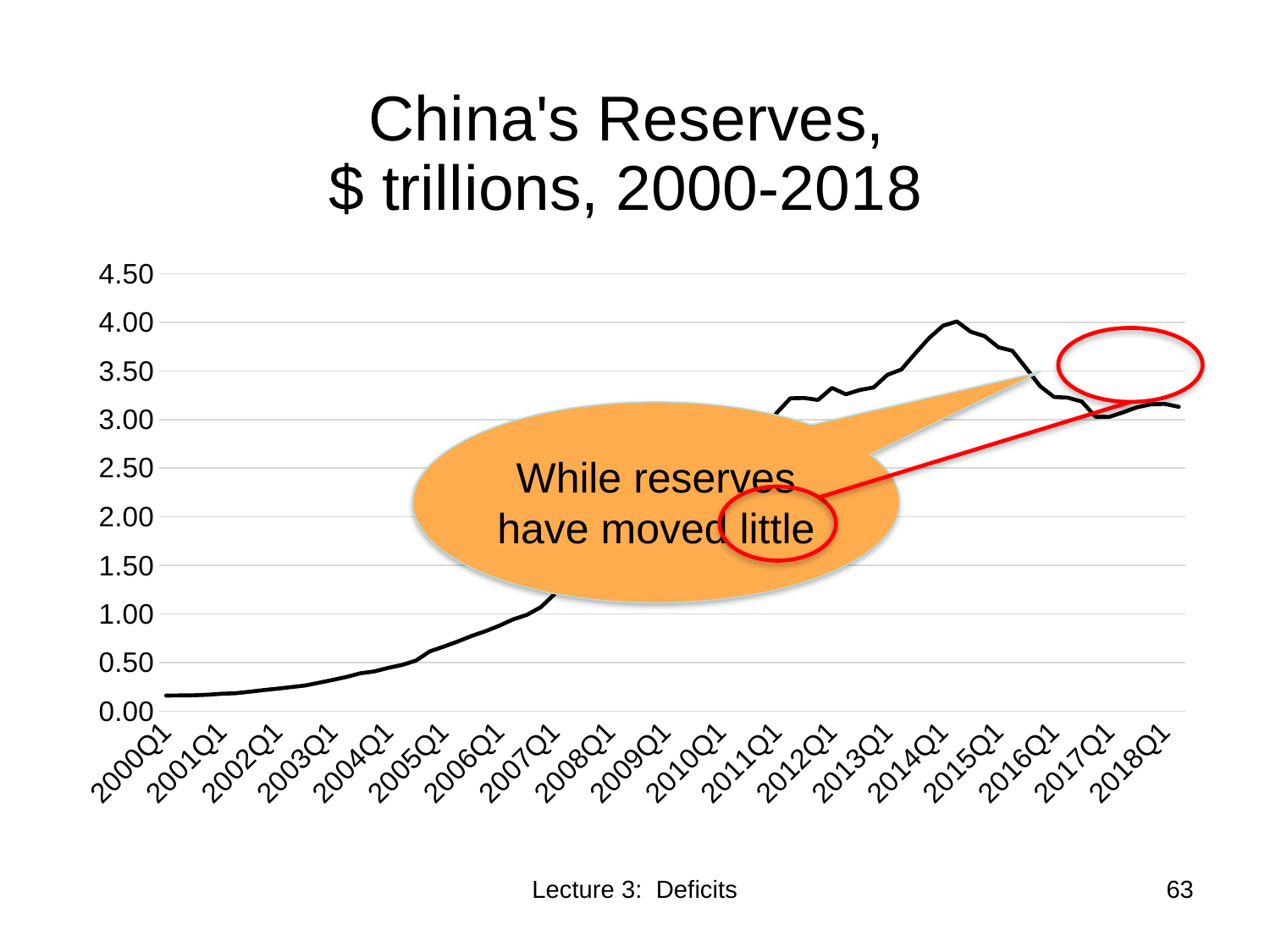
Do reserves rise or fall between 2000Q1 and 2014Q1? rise Is the value for 2005Q1 greater or less than 1.00? less Is the value for 2000Q1 greater or less than 0.50? less What kind of chart is shown on the slide? line chart What is the title of the chart? China's Reserves, $ trillions, 2000-2018 Do reserves rise or fall between 2015Q1 and 2017Q1? fall How many year labels are shown on the x axis? 19 Is the value for 2012Q1 greater or less than 3.00? greater What does the callout on the chart say? While reserves have moved little Which x-axis label has the lowest value on the chart? 2000Q1